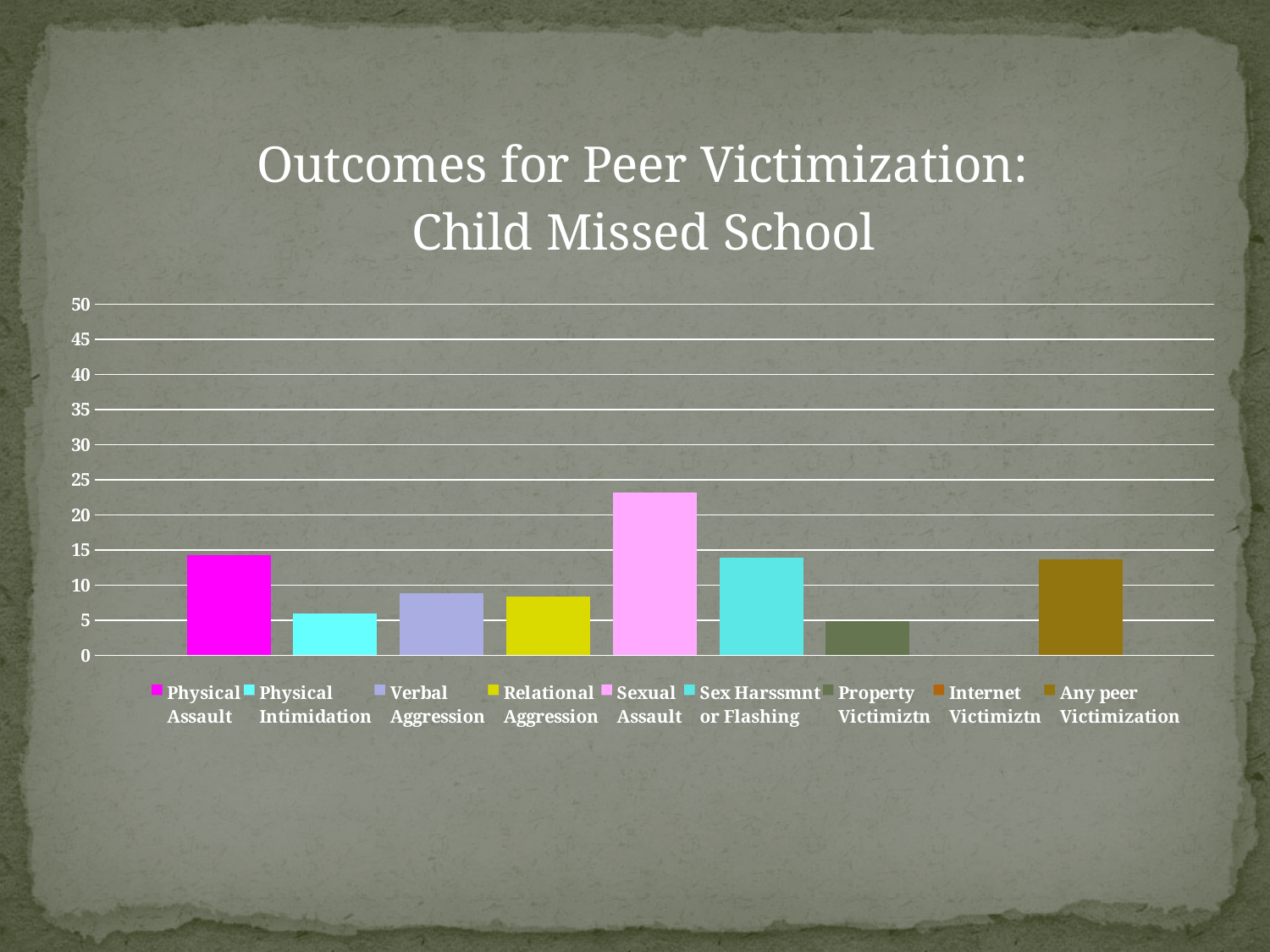
How many series does the legend list? 9 What colour is the bar for Sexual Assault? light pink Which category has the highest value? Sexual Assault Is the value for Sex Harssmnt or Flashing greater or less than 10? greater Which category has the lowest value? Internet Victimiztn Which is larger, the value for Verbal Aggression or the value for Physical Intimidation? Verbal Aggression Is the value for Sexual Assault greater or less than 20? greater Which is larger, the value for Sexual Assault or the value for Physical Assault? Sexual Assault Is the value for Property Victimiztn greater or less than 10? less What kind of chart is shown on the slide? bar chart What is the title of the chart? Outcomes for Peer Victimization: Child Missed School